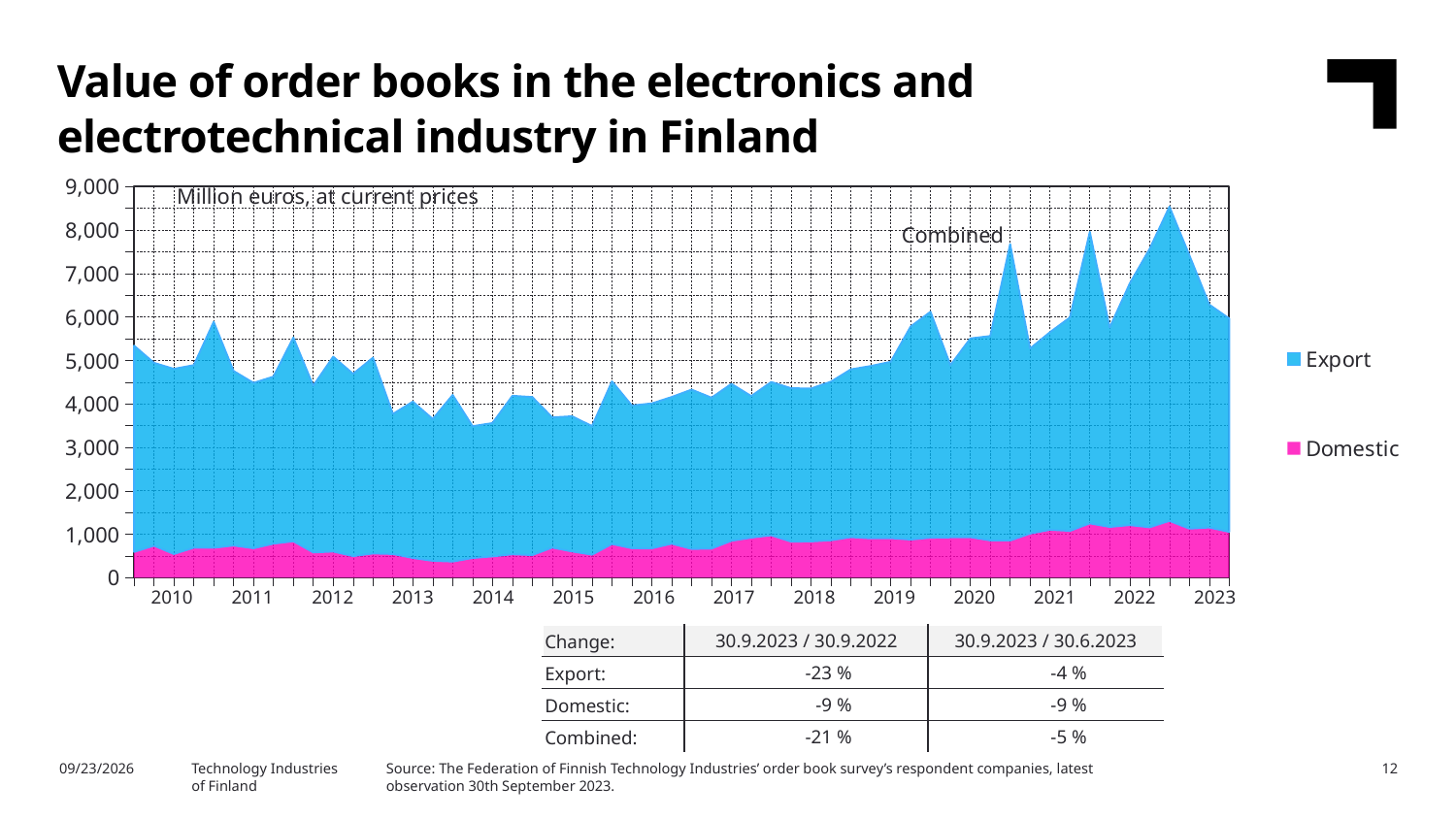
Does the combined order book value generally rise or fall between 2018 and 2022? Rise Which is larger, the combined value at the 2022 peak or the combined value at the start of 2010? The 2022 peak How many series does the chart legend list? 2 What kind of chart is shown on the slide? Area chart Is the combined value at its 2022 peak greater or less than 8,000? greater What are the two series named in the chart legend? Export and Domestic In which year does the combined order book value reach its highest peak? 2022 Is the Domestic value in 2013 greater or less than 1,000? less What unit is stated in the label inside the chart area? Million euros, at current prices According to the table below the chart, what is the Export change for 30.9.2023 / 30.9.2022? -23 %